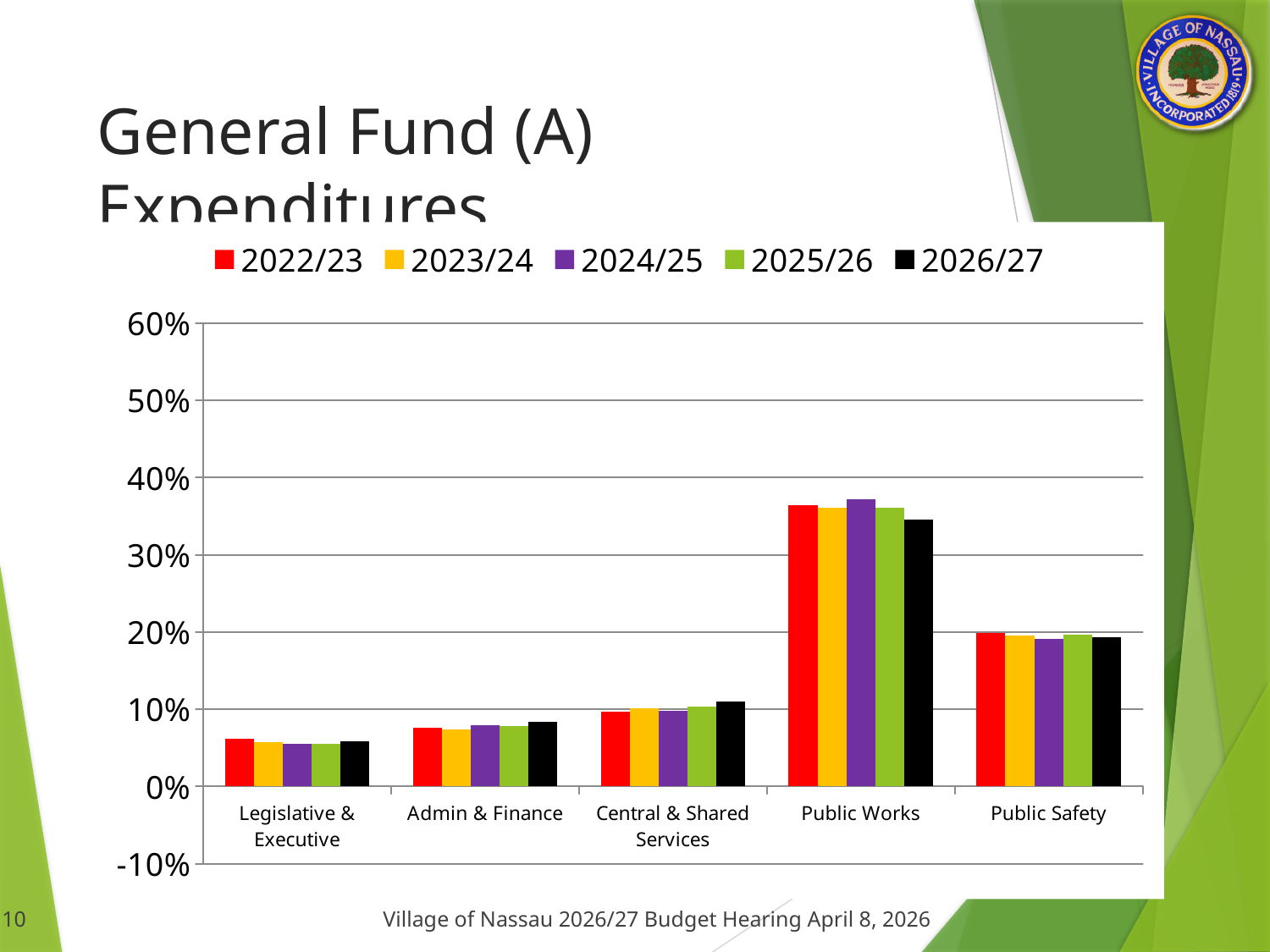
Which category has the lowest expenditure share across all years? Legislative & Executive Which category has the highest expenditure share across all years? Public Works Which is larger in 2022/23: Public Works or Public Safety? Public Works How many series does the legend list? 5 How many expenditure categories are shown on the x axis? 5 Is the value for Legislative & Executive in 2022/23 greater or less than 10%? less Is the value for Public Works in 2022/23 greater or less than 30%? greater Is the value for Admin & Finance in 2026/27 greater or less than 10%? less What kind of chart is shown on the slide? bar chart Within Public Works, which year has the lowest bar? 2026/27 What colour represents the 2026/27 series in the legend? black